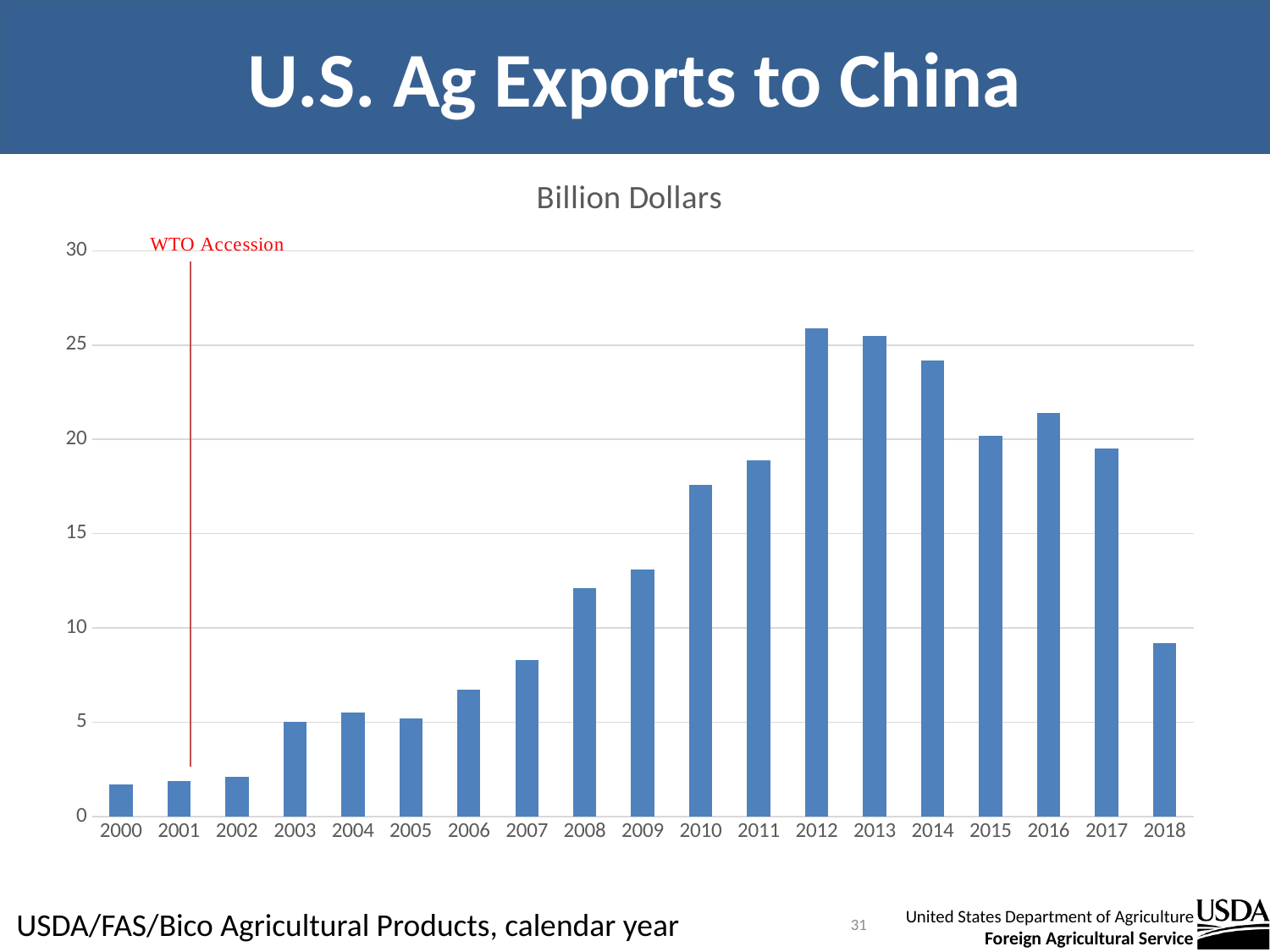
Is the value for 2007 greater or less than 10? less Is the value for 2018 greater or less than 10? less Is the value for 2008 greater or less than 10? greater What kind of chart is shown on the slide? Bar chart Which is larger, the value for 2016 or the value for 2017? 2016 Which is larger, the value for 2009 or the value for 2018? 2009 Which year has the highest value of U.S. ag exports to China? 2012 Do the values generally rise or fall from 2000 to 2012? rise What event does the red vertical line on the chart mark? WTO Accession How many years are shown on the x axis of the chart? 19